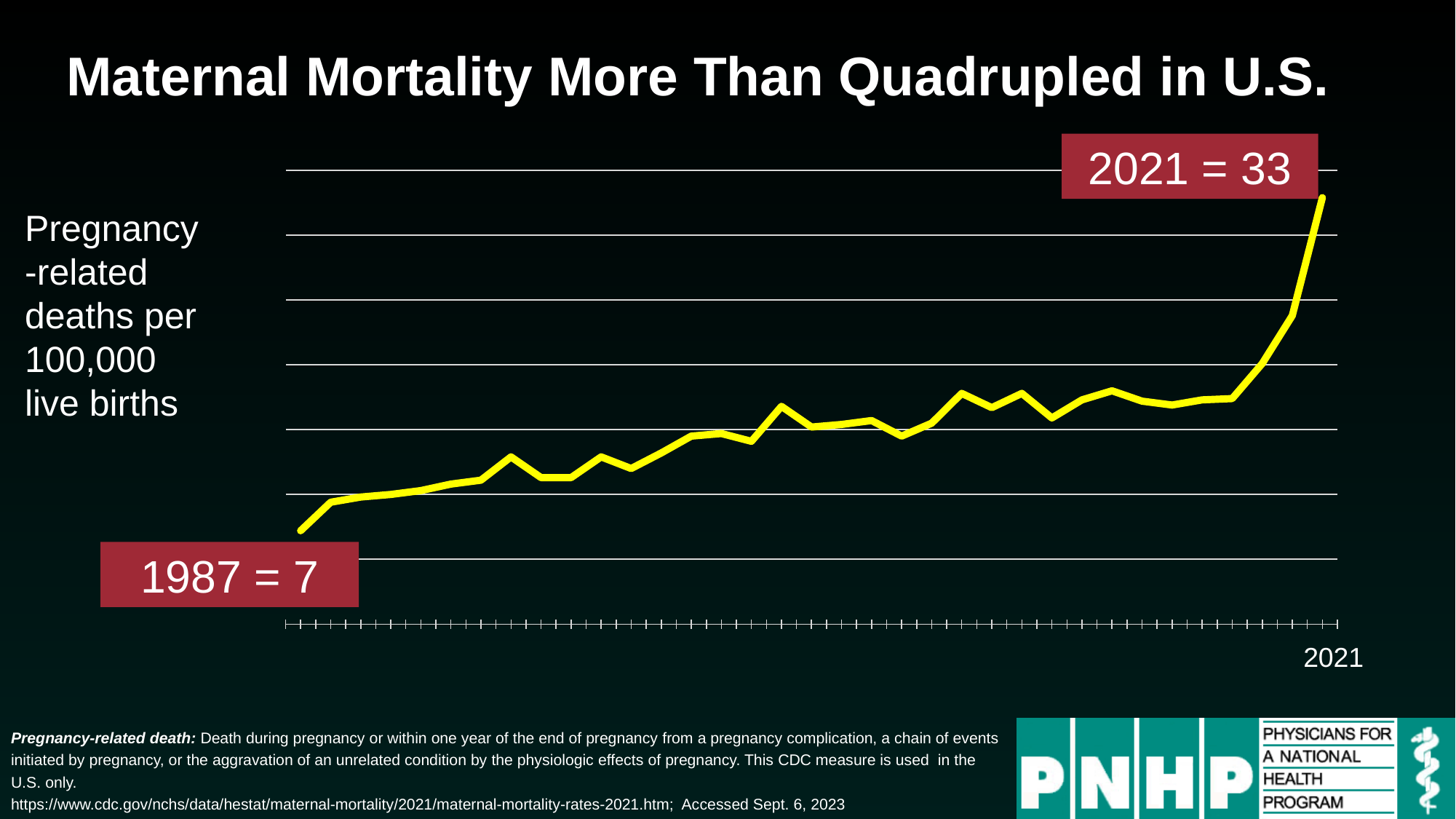
What is the title of the slide? Maternal Mortality More Than Quadrupled in U.S. What was the pregnancy-related death rate per 100,000 live births in 1987? 7 In which labelled year does the line reach its highest value? 2021 By how much did the pregnancy-related death rate increase from 1987 to 2021? 26 What does the vertical axis of the chart measure? Pregnancy-related deaths per 100,000 live births Which year has the higher pregnancy-related death rate, 1987 or 2021? 2021 In which labelled year does the line have its lowest value? 1987 Does the pregnancy-related death rate generally rise or fall from 1987 to 2021? Rise What was the pregnancy-related death rate per 100,000 live births in 2021? 33 What kind of chart is shown on the slide? Line chart